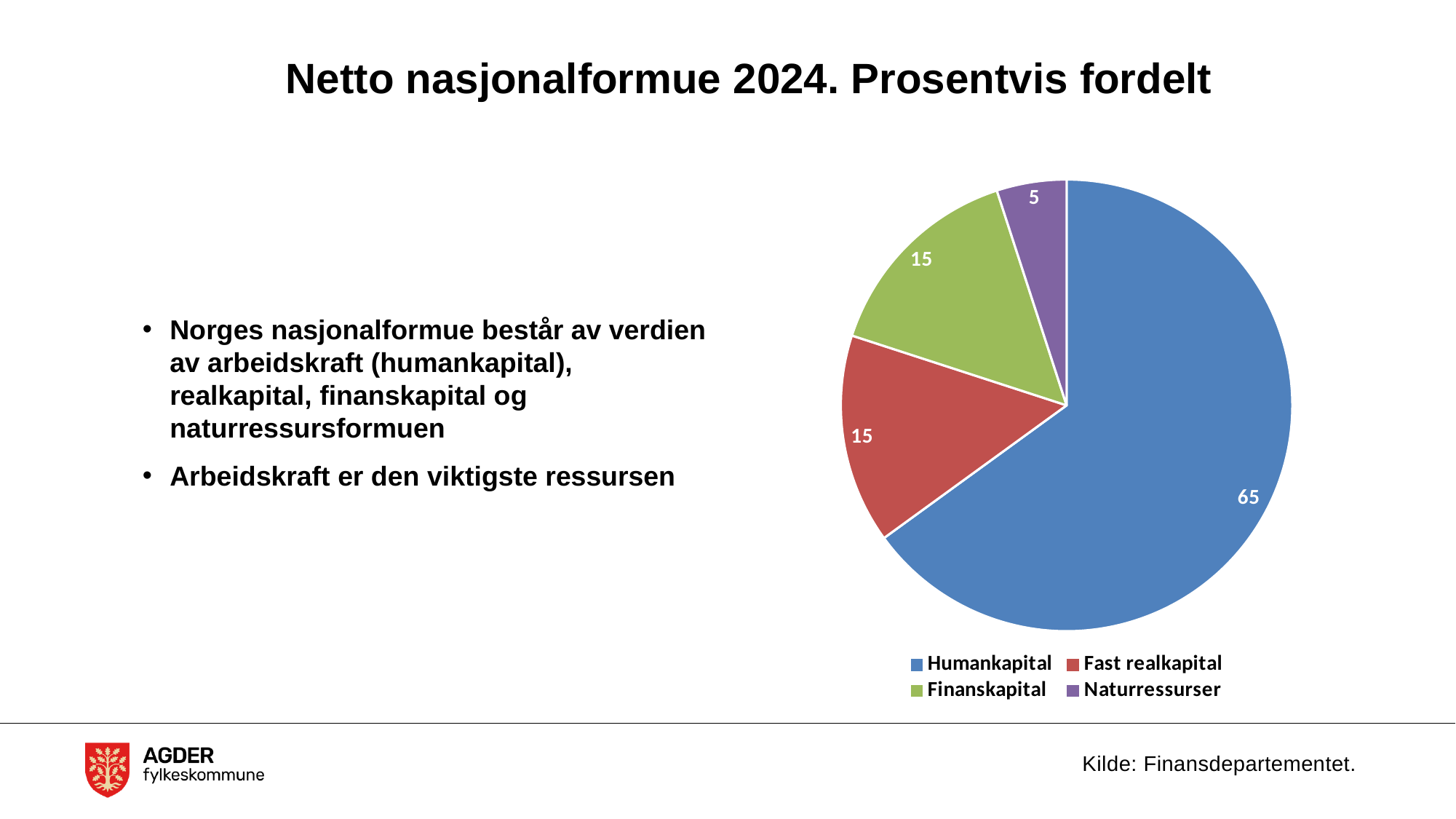
How many entries does the legend list? 4 Which is larger, Fast realkapital or Naturressurser? Fast realkapital What is the title of the chart on the slide? Netto nasjonalformue 2024. Prosentvis fordelt What is the value for Naturressurser? 5 What is the value for Humankapital? 65 Which category has the smallest slice? Naturressurser What is the difference between the values for Humankapital and Naturressurser? 60 Which category has the largest slice? Humankapital How many slices does the pie chart have? 4 What is the value for Finanskapital? 15 What is the value for Fast realkapital? 15 What kind of chart is shown on the slide? Pie chart